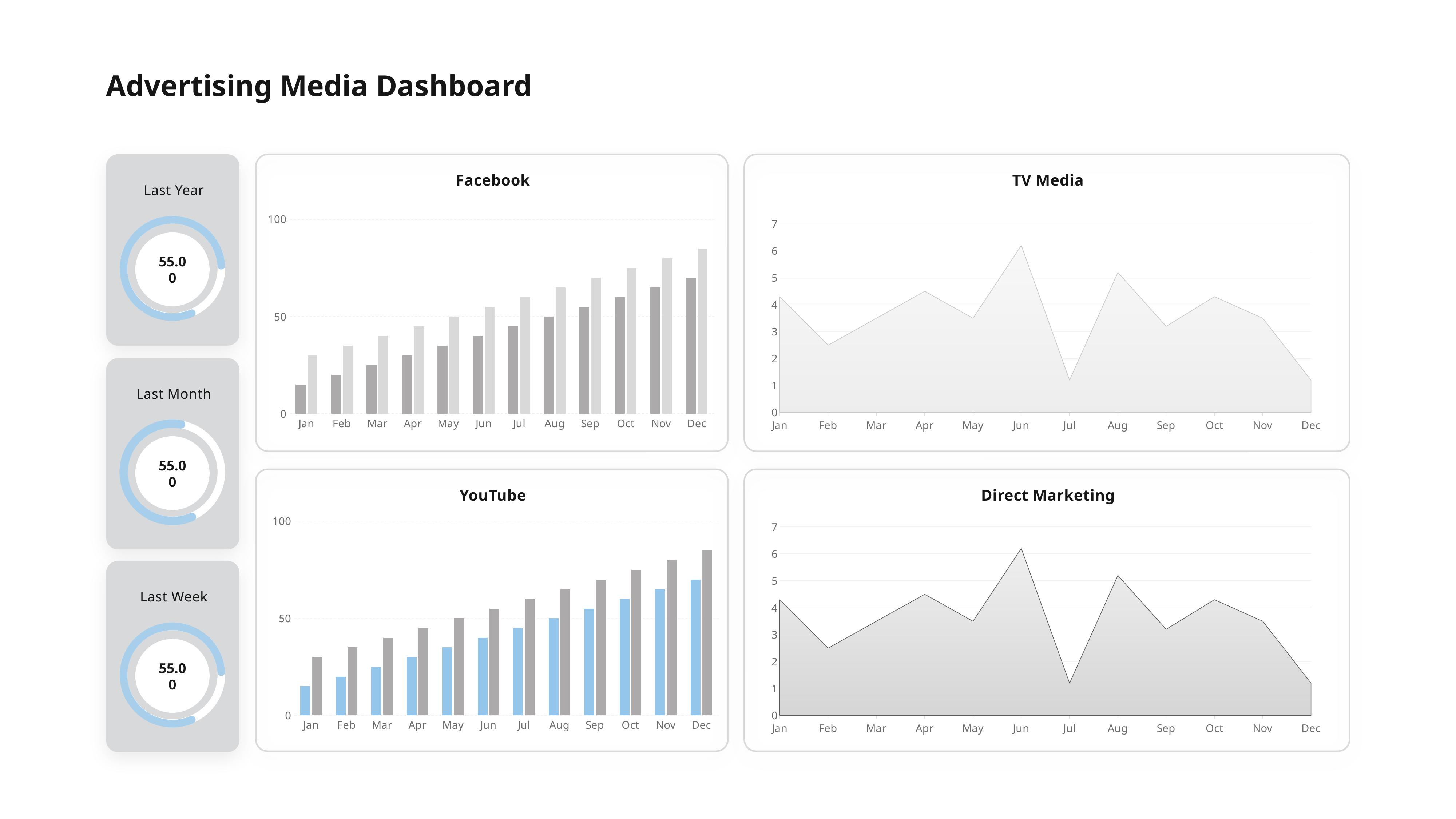
In the Direct Marketing chart, which is larger, the value for Jun or the value for Jul? Jun What is the title of the chart in the top right of the slide? TV Media How many months are plotted on the x axis of the Direct Marketing chart? 12 What kind of chart is the Facebook chart? bar chart In the TV Media chart, which month has the highest value? Jun In the Facebook chart, is the value of the dark bar for Jan greater or less than 50? less In the YouTube chart, is the value of the blue bar for Dec greater or less than 50? greater In the TV Media chart, is the value for Jul greater or less than 2? less What kind of chart is the YouTube chart? bar chart In the Facebook chart, do the bars generally rise or fall from Jan to Dec? rise How many months are shown on the x axis of the Facebook chart? 12 In the Facebook chart, which month has the tallest bars? Dec